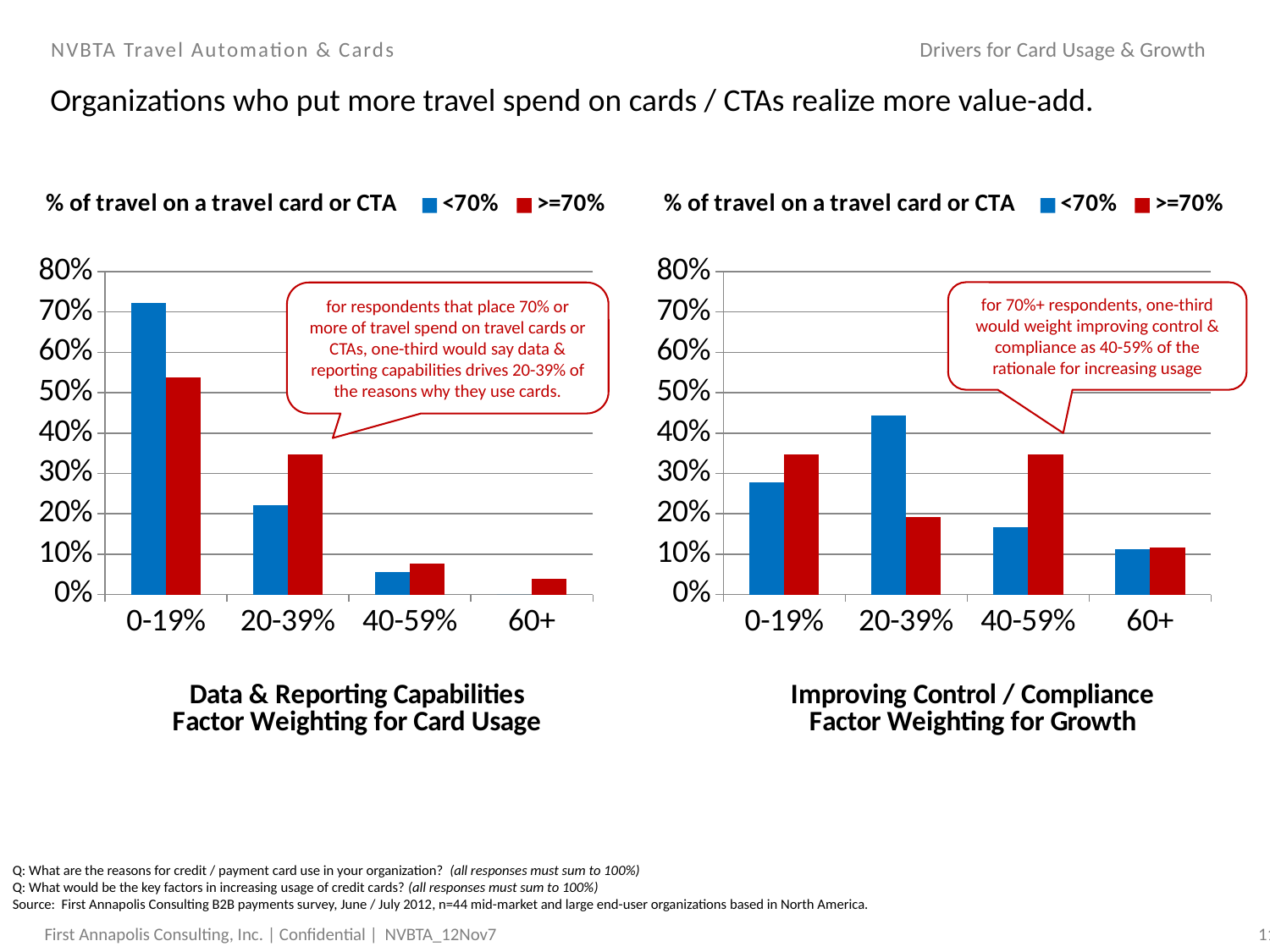
On the left chart (Data & Reporting Capabilities Factor Weighting for Card Usage), is the value for <70% in the 40-59% category greater or less than 10%? less On the right chart (Improving Control / Compliance Factor Weighting for Growth), which series has the larger value in the 40-59% category, <70% or >=70%? >=70% On the left chart (Data & Reporting Capabilities Factor Weighting for Card Usage), is the value for >=70% in the 0-19% category greater or less than 50%? greater On the left chart (Data & Reporting Capabilities Factor Weighting for Card Usage), which series has the larger value in the 20-39% category, <70% or >=70%? >=70% How many series does the legend of the right chart (Improving Control / Compliance Factor Weighting for Growth) list? 2 What kind of chart is the left chart (Data & Reporting Capabilities Factor Weighting for Card Usage)? Bar chart On the left chart (Data & Reporting Capabilities Factor Weighting for Card Usage), is the value for <70% in the 0-19% category greater or less than 70%? greater How many categories are shown on the x axis of the left chart (Data & Reporting Capabilities Factor Weighting for Card Usage)? 4 On the right chart (Improving Control / Compliance Factor Weighting for Growth), which category has the highest value for the <70% series? 20-39% On the left chart (Data & Reporting Capabilities Factor Weighting for Card Usage), which category has the highest value for the <70% series? 0-19%